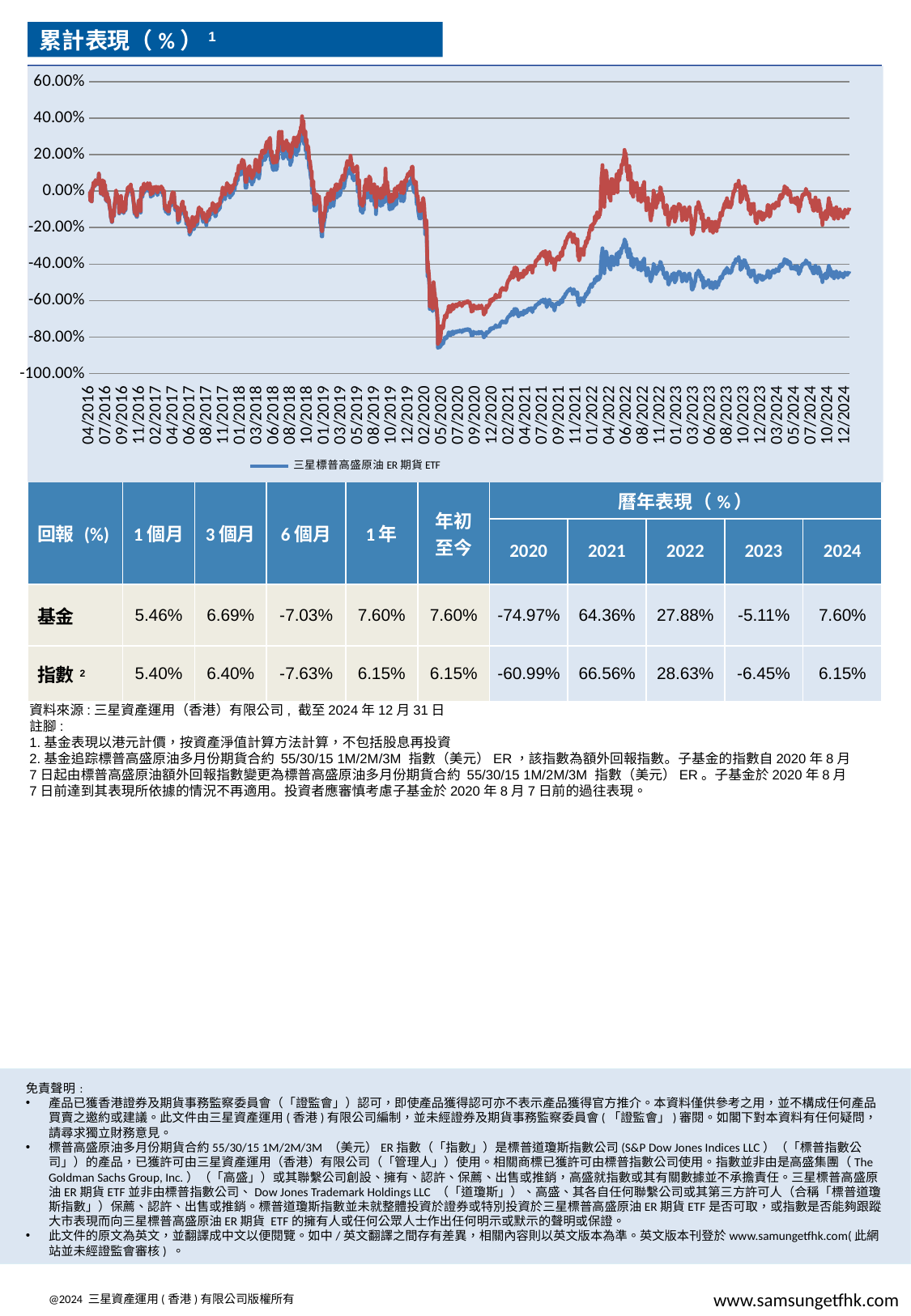
What is the title of the chart on the slide? 累計表現（%） What is the legend entry shown below the 累計表現（%） chart? 三星標普高盛原油 ER 期貨 ETF In the 累計表現（%） chart, is the value of the 三星標普高盛原油 ER 期貨 ETF line at 12/2024 greater or less than -20.00%? less In the 累計表現（%） chart, is the value of the 三星標普高盛原油 ER 期貨 ETF line at 12/2024 greater or less than -60.00%? greater What is the first date label on the x axis of the 累計表現（%） chart? 04/2016 In the 累計表現（%） chart, is the peak of the 三星標普高盛原油 ER 期貨 ETF line around 10/2018 greater or less than 20.00%? greater What kind of chart is shown under the title 累計表現（%）? line chart How many series does the legend of the 累計表現（%） chart list? 1 In the 累計表現（%） chart, which line is higher at 12/2024, the red line or the blue line? the red line In the 累計表現（%） chart, does the 三星標普高盛原油 ER 期貨 ETF line end higher or lower at 12/2024 than where it started at 04/2016? lower